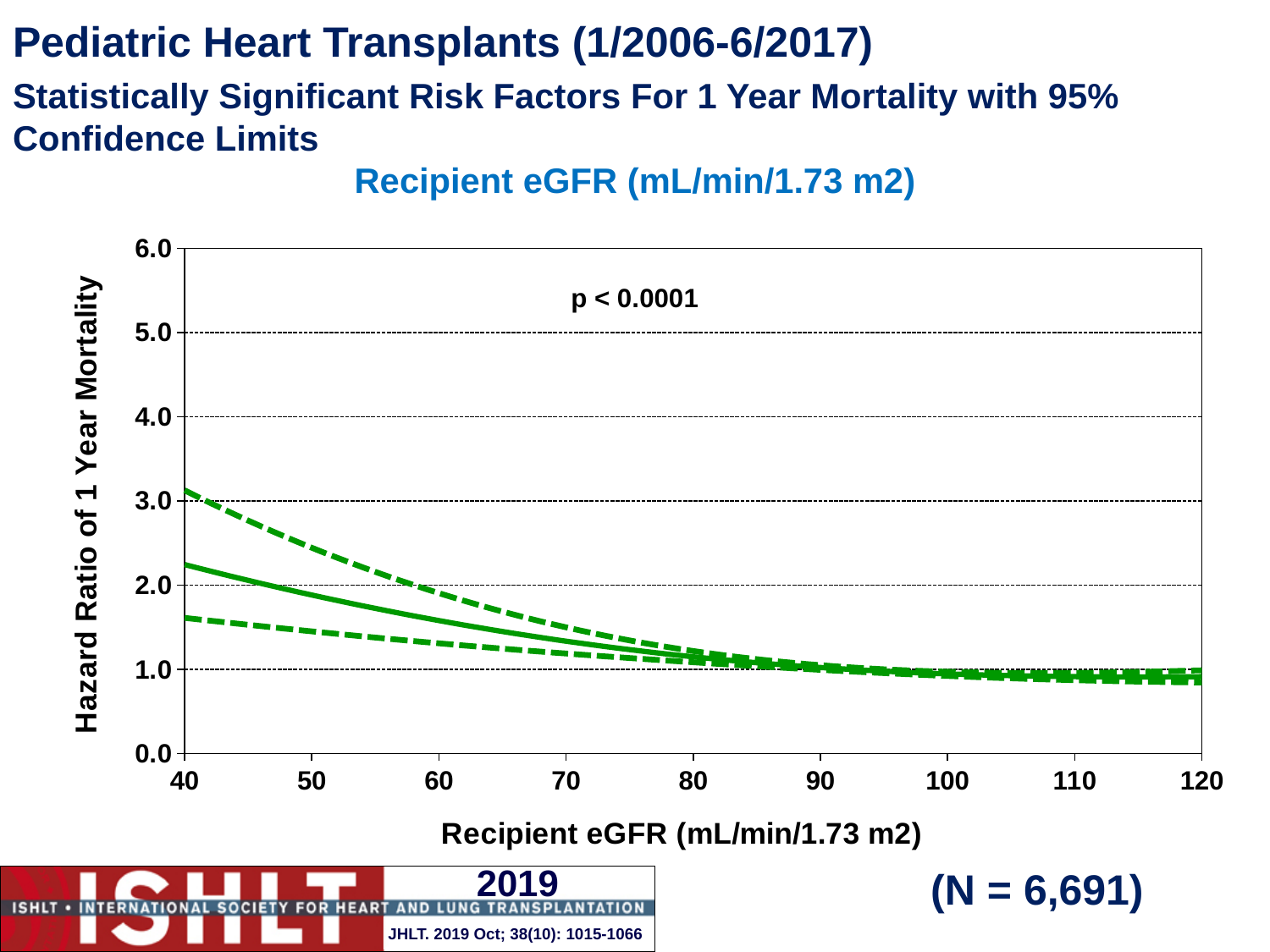
Does the hazard ratio (solid line) rise or fall as recipient eGFR increases from 40 to 120? fall What p-value is printed on the chart? p < 0.0001 Which is larger at a recipient eGFR of 50: the upper dashed confidence limit or the lower dashed confidence limit? upper dashed confidence limit Is the hazard ratio on the solid line at a recipient eGFR of 60 greater or less than 2.0? less Is the hazard ratio on the solid line at a recipient eGFR of 60 greater or less than 1.0? greater What is the label of the y-axis? Hazard Ratio of 1 Year Mortality Is the upper dashed confidence limit at a recipient eGFR of 40 greater or less than 2.0? greater How many lines are plotted on the chart? 3 What kind of chart is shown on the slide? line chart